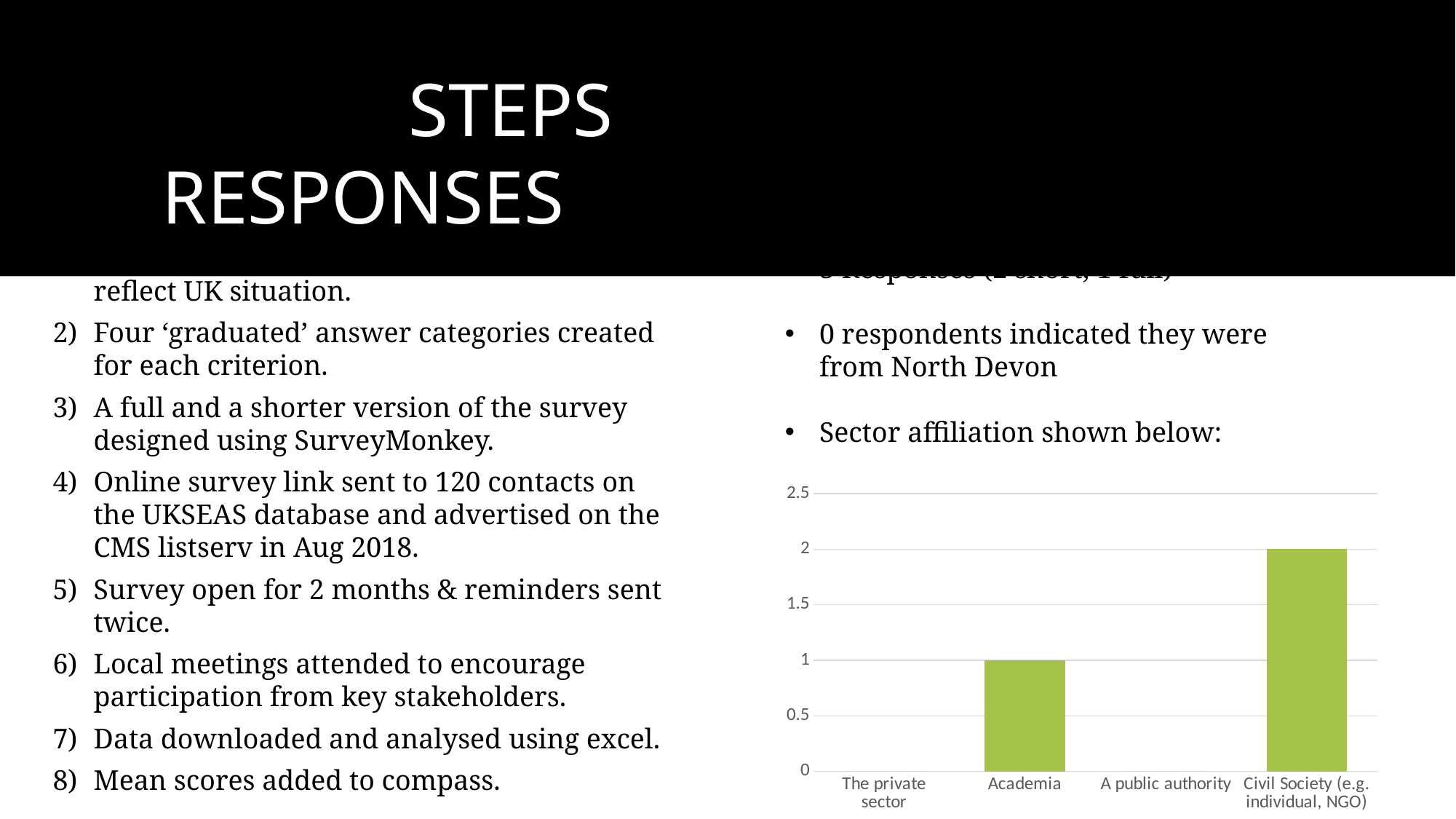
What is the value for A public authority in the chart? 0 What is the difference between the values for Civil Society (e.g. individual, NGO) and Academia? 1 Is the value for Civil Society (e.g. individual, NGO) greater or less than 1.5? greater What is the value for Academia in the chart? 1 What colour are the bars in the chart? green What is the value for Civil Society (e.g. individual, NGO) in the chart? 2 What is the value for The private sector in the chart? 0 Which category has the highest value in the chart? Civil Society (e.g. individual, NGO) How many categories are shown on the x axis of the chart? 4 What is the highest value shown on the chart's y axis? 2.5 What kind of chart is shown on the slide? bar chart Which is larger, the value for Academia or the value for Civil Society (e.g. individual, NGO)? Civil Society (e.g. individual, NGO)